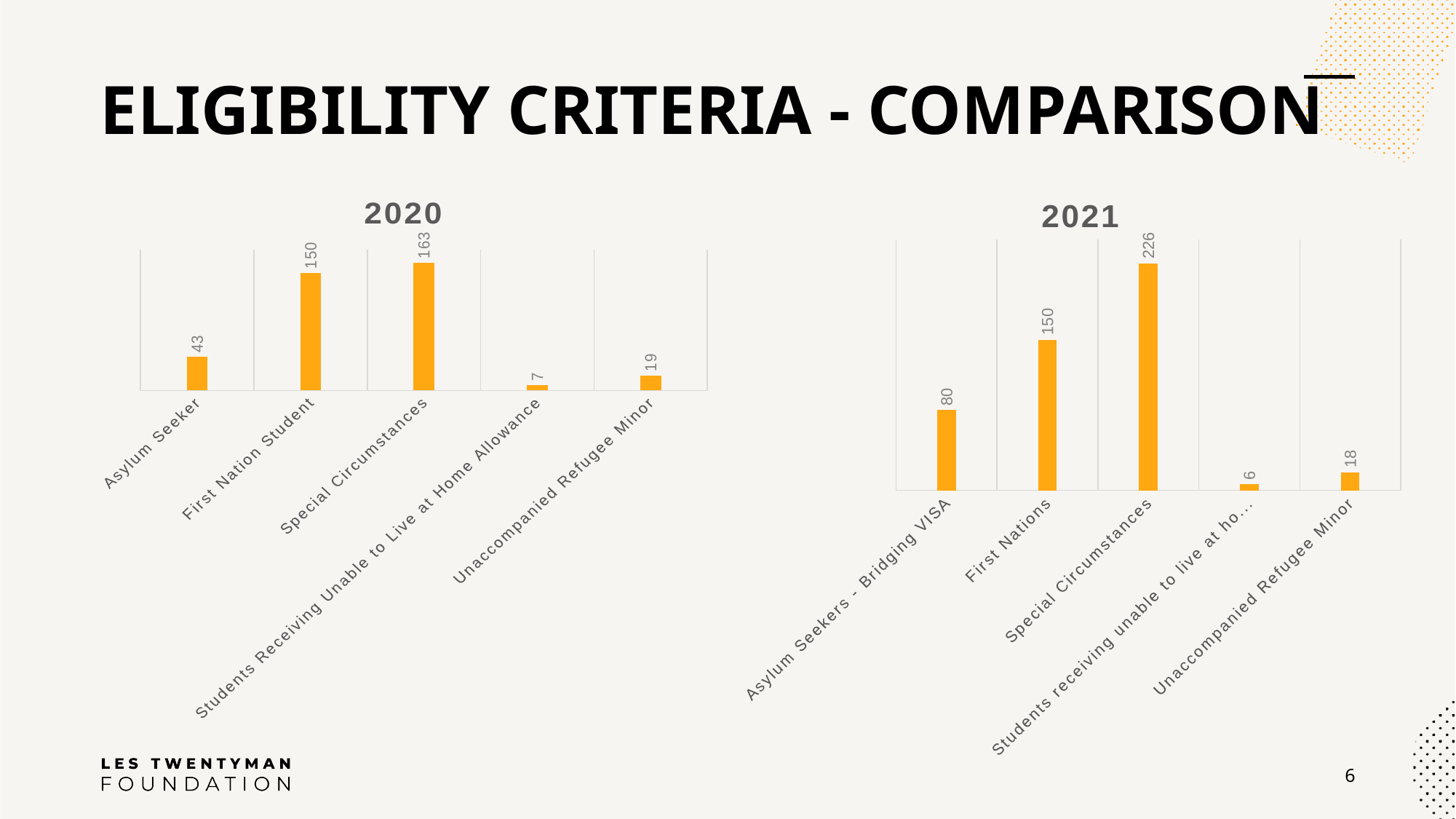
In the 2020 chart, what is the difference between First Nation Student and Asylum Seeker? 107 What kind of chart is the 2020 chart? Bar chart In the 2020 chart, which category has the highest value? Special Circumstances In the 2021 chart, what is the difference between Special Circumstances and First Nations? 76 In the 2021 chart, which category has the lowest value? Students receiving unable to live at ho... In the 2020 chart, what is the value for Asylum Seeker? 43 How many categories does the 2021 chart show? 5 In the 2020 chart, what is the value for Special Circumstances? 163 What is the title of the chart on the right side of the slide? 2021 In the 2021 chart, what is the value for Asylum Seekers - Bridging VISA? 80 In the 2021 chart, what is the value for Unaccompanied Refugee Minor? 18 In the 2020 chart, which is larger: Unaccompanied Refugee Minor or Asylum Seeker? Asylum Seeker